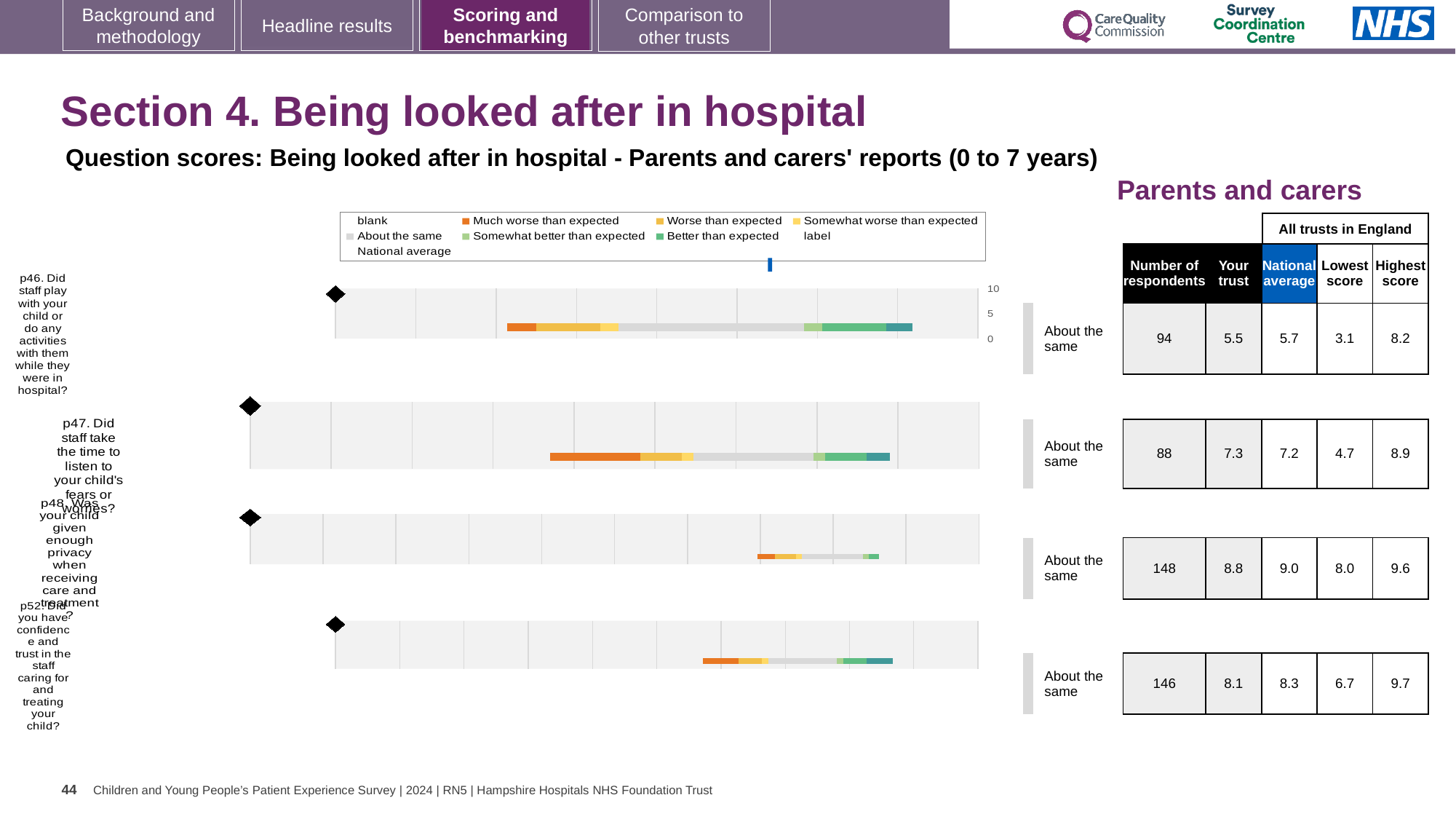
What is the highest score among all trusts in England for question p52 (Did you have confidence and trust in the staff caring for and treating your child?)? 9.7 Which question has the lowest 'Your trust' score? p46 How many respondents answered question p48 (Was your child given enough privacy when receiving care and treatment?)? 148 Which question has the highest 'Your trust' score? p48 What benchmark category is shown next to each of the four bars? About the same What kind of chart is used to show the question scores on this slide? bar chart How many survey questions (bars) are plotted on the slide? 4 What is the national average score for question p47 (Did staff take the time to listen to your child's fears or worries?)? 7.2 For question p46, what is the difference between the highest score and the lowest score among all trusts in England? 5.1 What is the lowest score among all trusts in England for question p48? 8.0 What is the 'Your trust' score for question p46 (Did staff play with your child or do any activities with them while they were in hospital?)? 5.5 For question p47, which is larger: the 'Your trust' score or the national average? Your trust